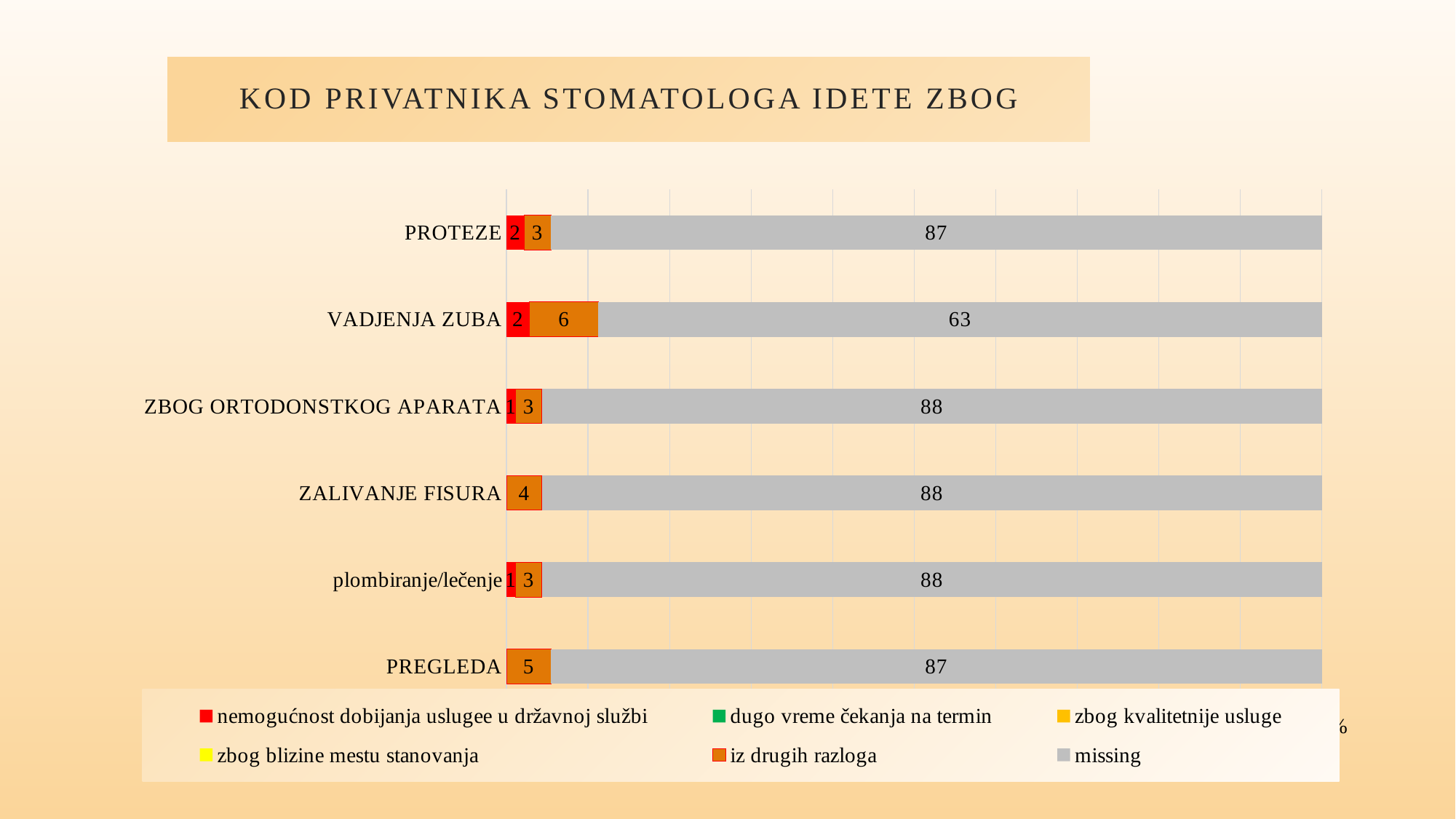
What is the difference between the "missing" values for PROTEZE and VADJENJA ZUBA? 24 What is the value of the "iz drugih razloga" segment for ZALIVANJE FISURA? 4 How many series does the legend list? 6 What is the value of the "nemogućnost dobijanja uslugee u državnoj službi" segment for PROTEZE? 2 How many categories are shown on the chart? 6 Which category has the lowest "missing" value? VADJENJA ZUBA Which is larger: the "iz drugih razloga" value for VADJENJA ZUBA or for PREGLEDA? VADJENJA ZUBA What is the value of the "iz drugih razloga" segment for PREGLEDA? 5 Which category has the highest "iz drugih razloga" value? VADJENJA ZUBA What is the title of the slide? KOD PRIVATNIKA STOMATOLOGA IDETE ZBOG What is the value of the "missing" segment for VADJENJA ZUBA? 63 What kind of chart is shown on the slide? Stacked bar chart